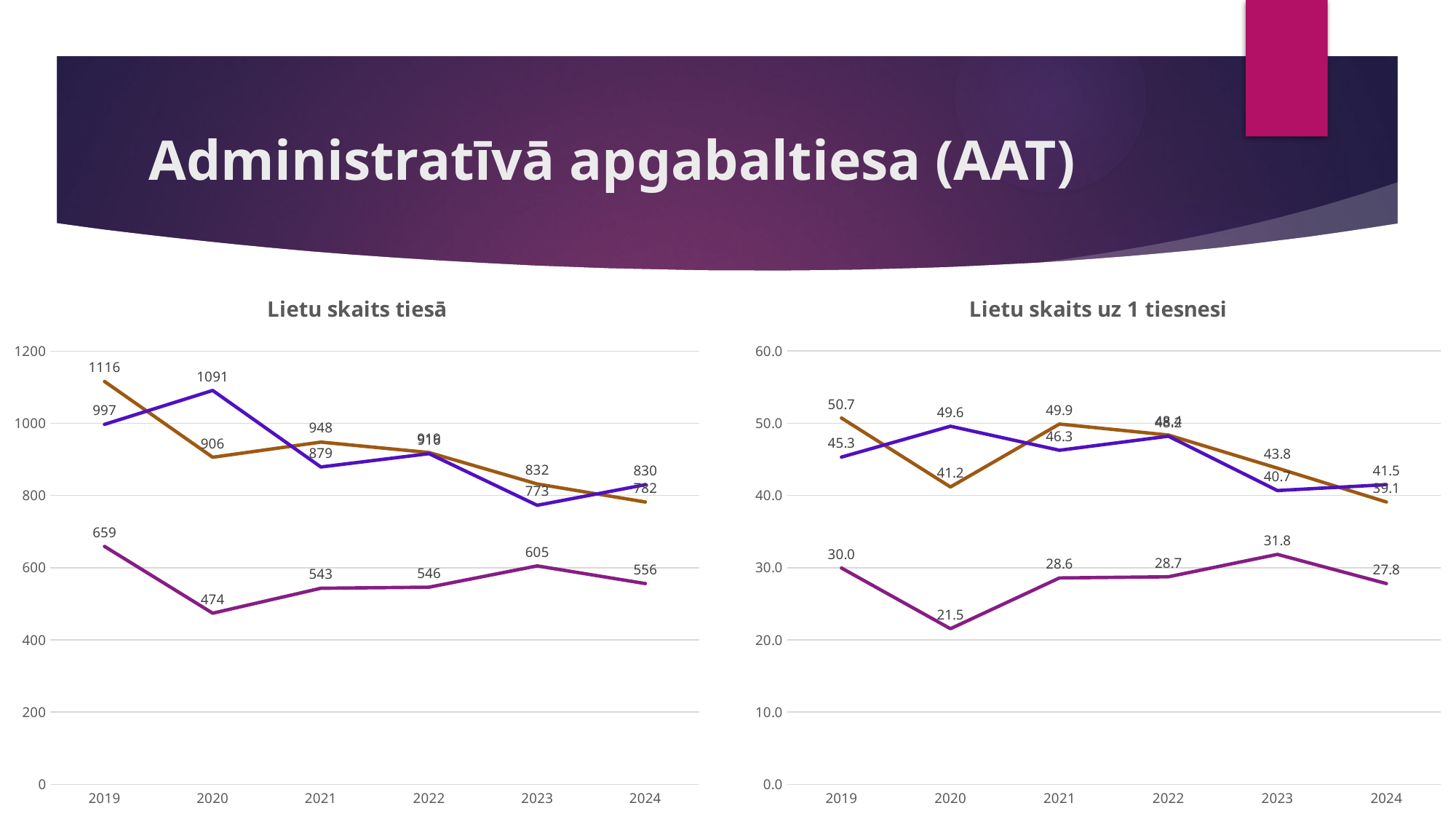
In the chart titled "Lietu skaits uz 1 tiesnesi", what is the value of the brown line in 2024? 39.1 In the chart titled "Lietu skaits tiesā", in which year does the purple line reach its highest value? 2019 In the chart titled "Lietu skaits uz 1 tiesnesi", is the value of the blue line in 2023 greater or less than 50.0? less In the chart titled "Lietu skaits tiesā", by how much did the blue line increase from 2019 to 2020? 94 In the chart titled "Lietu skaits tiesā", in which year does the purple line reach its lowest value? 2020 In the chart titled "Lietu skaits uz 1 tiesnesi", which line has the higher value in 2020, the blue line or the brown line? The blue line How many years are shown on the x axis of the chart titled "Lietu skaits tiesā"? 6 In the chart titled "Lietu skaits tiesā", what is the value of the brown line in 2019? 1116 In the chart titled "Lietu skaits uz 1 tiesnesi", what is the difference between the purple line's values in 2019 and 2020? 8.5 In the chart titled "Lietu skaits tiesā", what is the value of the purple line in 2020? 474 What kind of chart is the chart titled "Lietu skaits tiesā"? Line chart In the chart titled "Lietu skaits uz 1 tiesnesi", what is the value of the purple line in 2023? 31.8